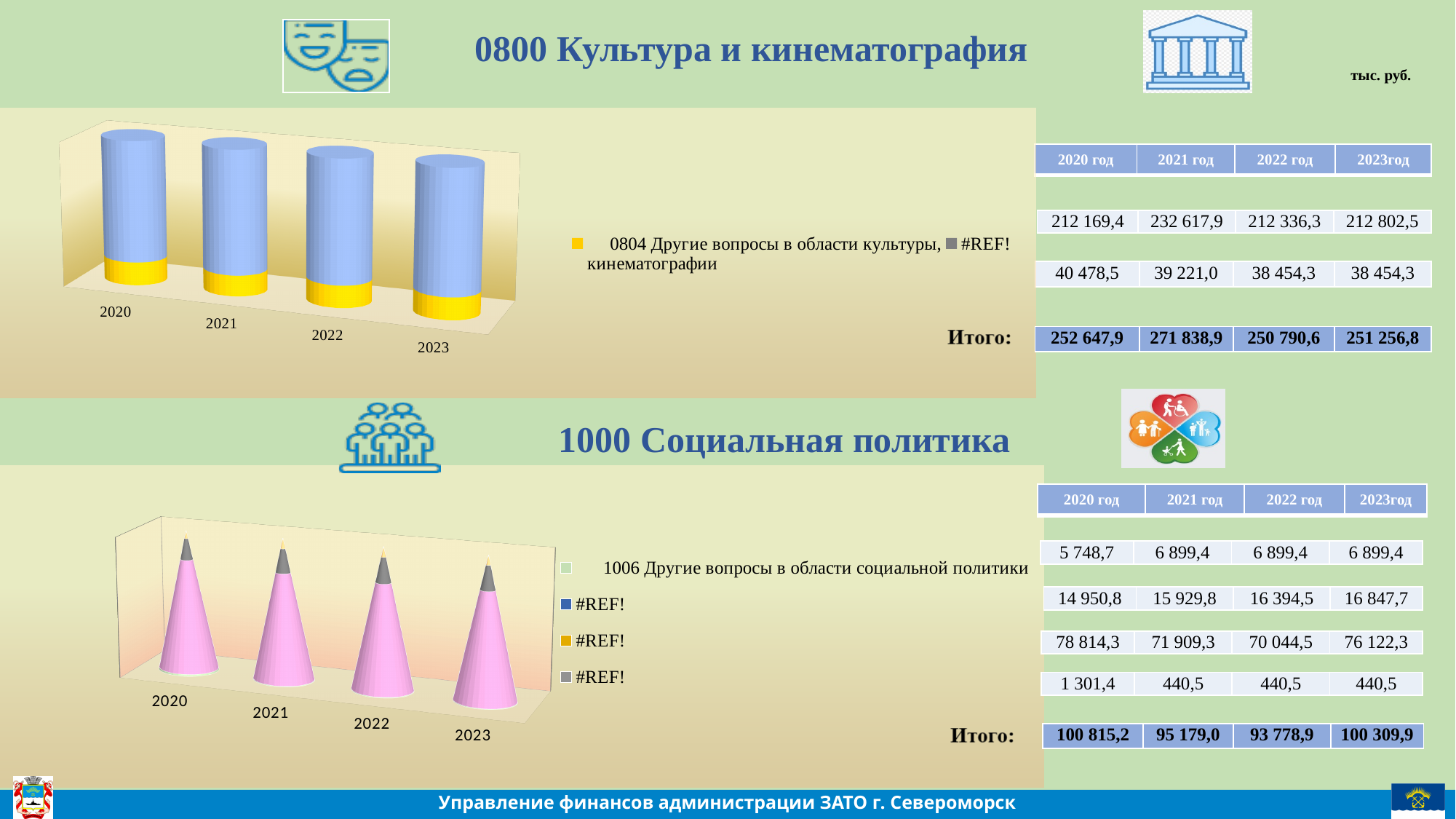
What kind of chart is shown under the heading "1000 Социальная политика"? bar chart In the table next to the chart under "1000 Социальная политика", what is the Итого value for 2022 год? 93 778,9 In the chart under "0800 Культура и кинематография", what is the first year shown on the x axis? 2020 In the chart under "0800 Культура и кинематография", which legend entry is shown in yellow? 0804 Другие вопросы в области культуры, кинематографии How many entries does the legend of the chart under "0800 Культура и кинематография" list? 2 How many entries does the legend of the chart under "1000 Социальная политика" list? 4 In the chart under "1000 Социальная политика", what is the first legend entry? 1006 Другие вопросы в области социальной политики In the chart under "0800 Культура и кинематография", how many years are shown on the x axis? 4 In the chart under "1000 Социальная политика", how many categories are shown on the x axis? 4 In the table next to the chart under "0800 Культура и кинематография", what is the Итого value for 2021 год? 271 838,9 What kind of chart is shown under the heading "0800 Культура и кинематография"? bar chart In the chart under "1000 Социальная политика", what is the last year shown on the x axis? 2023